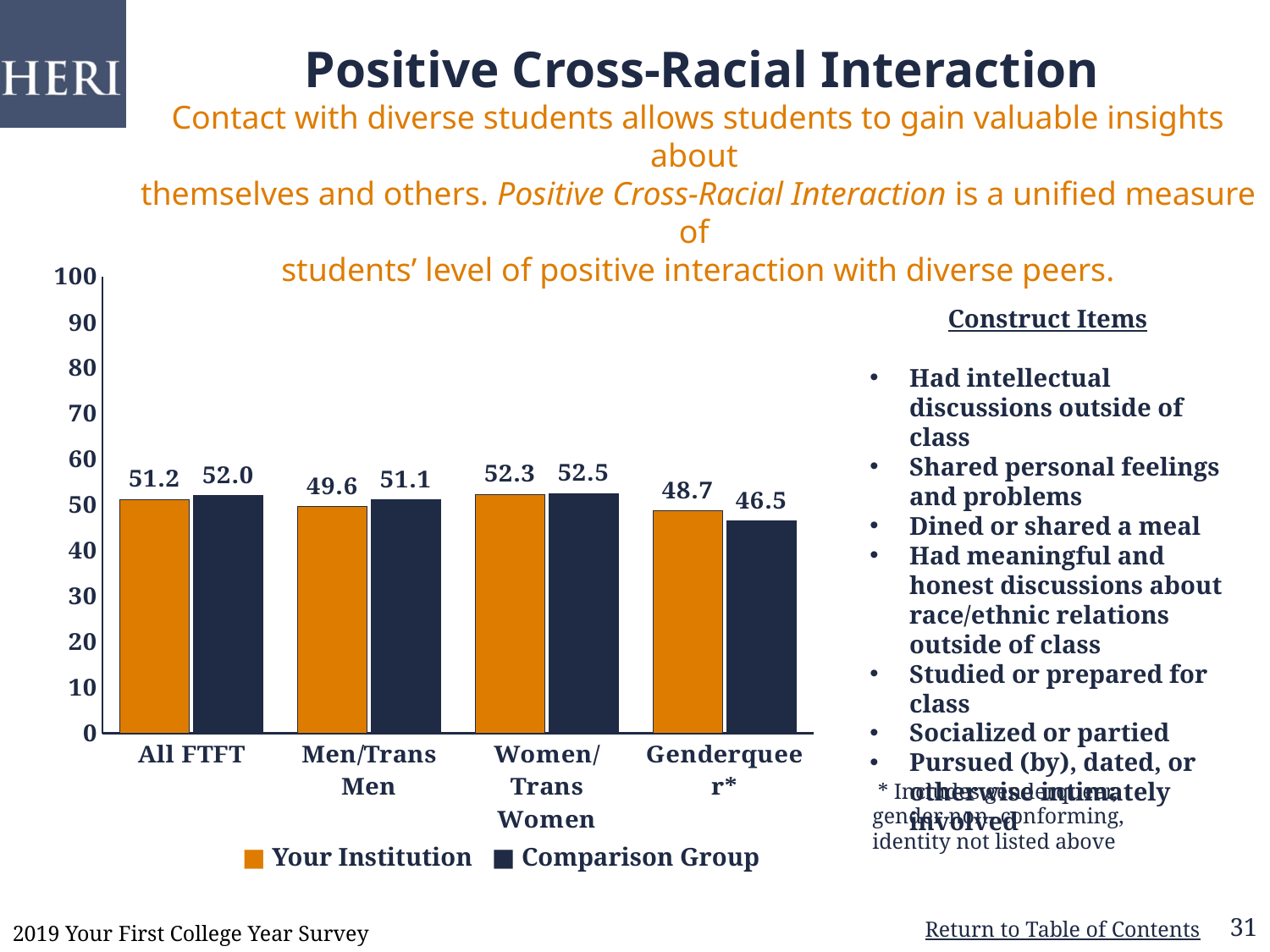
How many categories are shown on the x axis? 4 Which category has the lowest value for Your Institution? Genderqueer What is the value for Your Institution in the Women/Trans Women category? 52.3 What is the difference between the Comparison Group and Your Institution values in the Men/Trans Men category? 1.5 How many series does the legend list? 2 What is the value for Your Institution in the All FTFT category? 51.2 Is the value for Your Institution in the Men/Trans Men category greater or less than 50? less What kind of chart is shown on the slide? bar chart Which category has the highest value for the Comparison Group? Women/Trans Women What colour represents Your Institution in the chart? orange In the Genderqueer category, which is larger: Your Institution or the Comparison Group? Your Institution What is the value for the Comparison Group in the Genderqueer category? 46.5